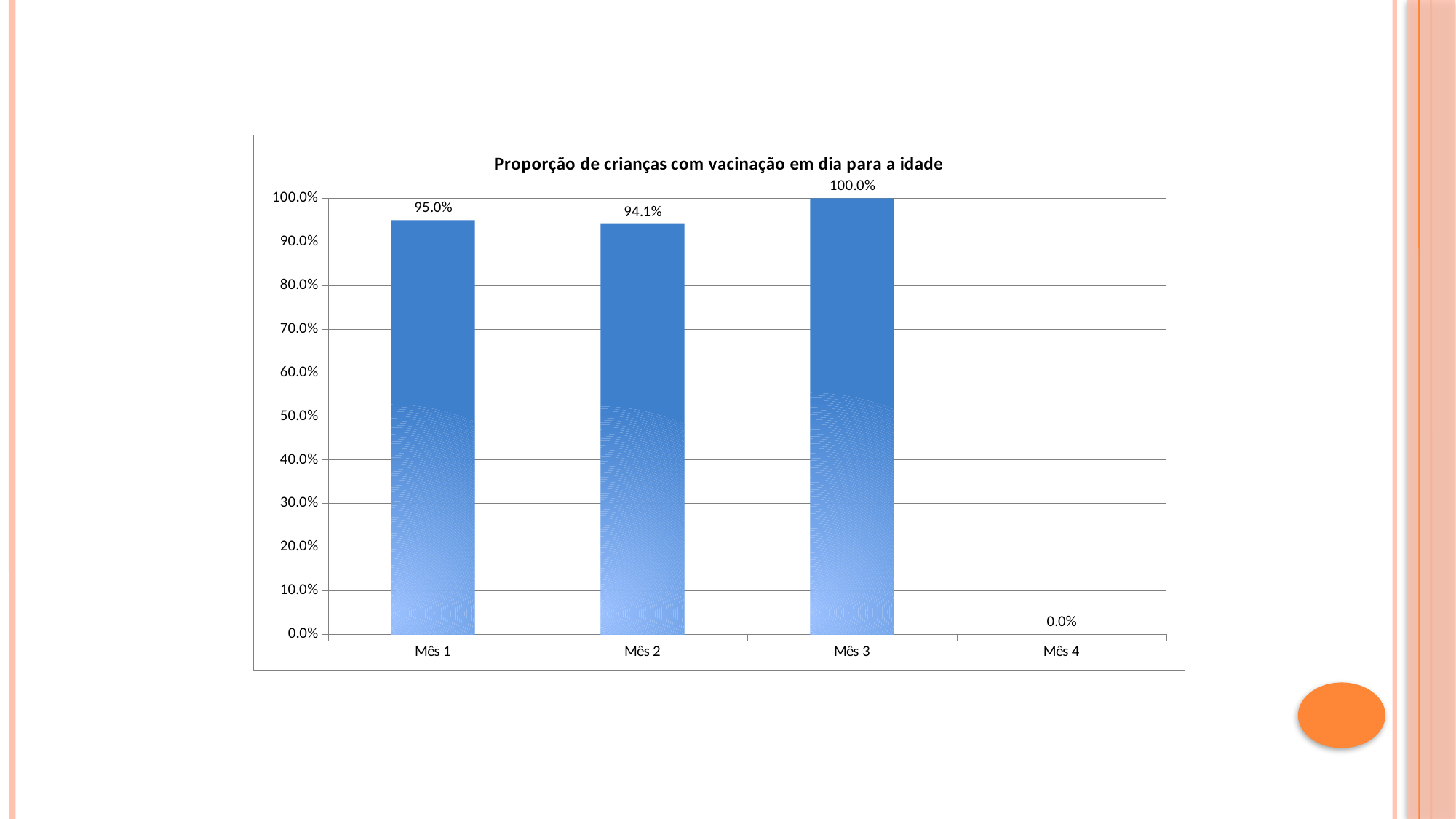
What is the difference between the values for Mês 1 and Mês 2? 0.9% How many categories are shown on the x axis? 4 What is the value for Mês 4? 0.0% Which category has the highest value? Mês 3 What is the difference between the values for Mês 3 and Mês 1? 5.0% What is the title of the chart? Proporção de crianças com vacinação em dia para a idade What is the value for Mês 1? 95.0% What is the value for Mês 3? 100.0% Which category has the lowest value? Mês 4 What kind of chart is shown on the slide? Bar chart Which is larger, the value for Mês 3 or the value for Mês 2? Mês 3 What is the value for Mês 2? 94.1%